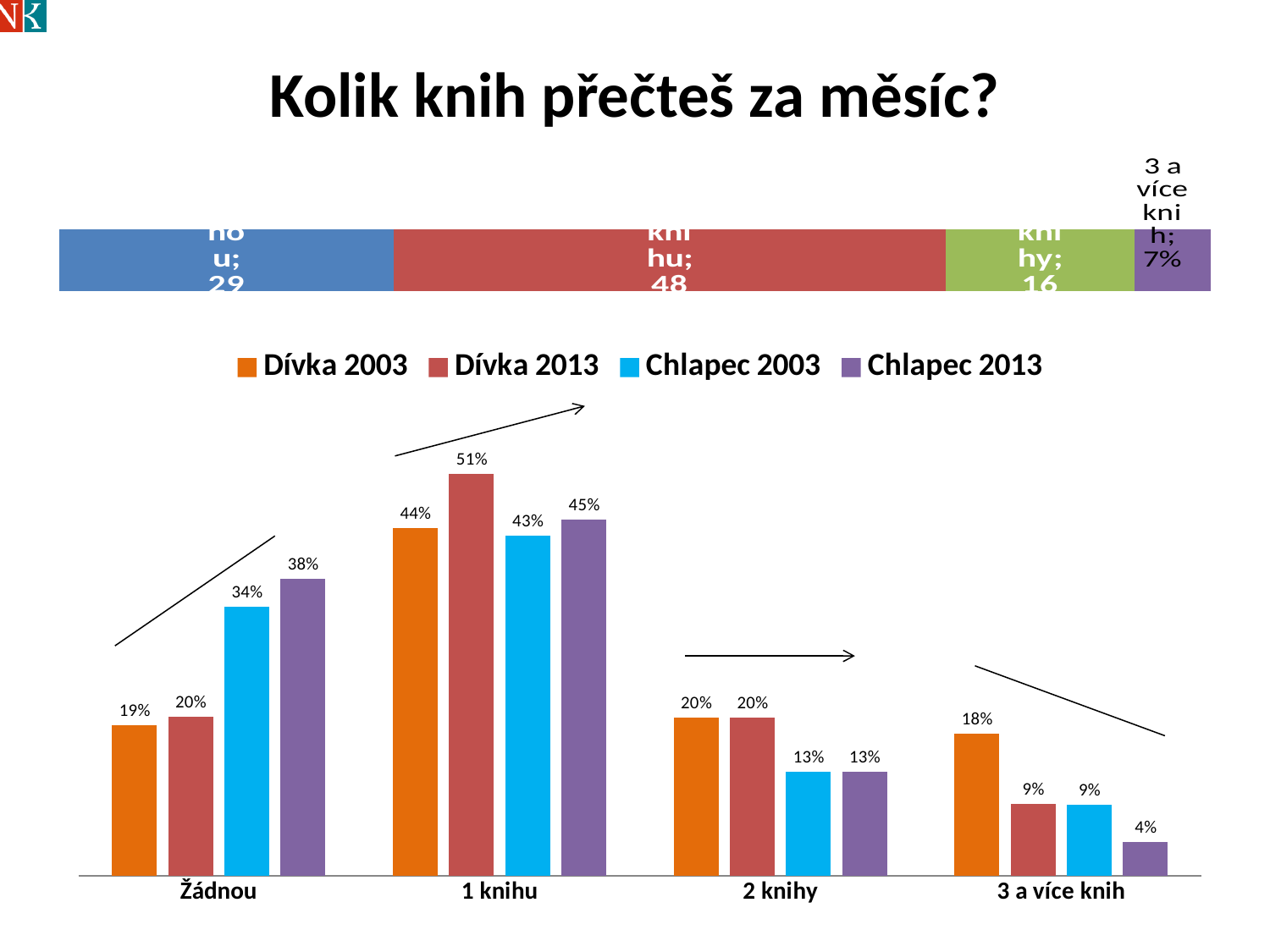
In the lower bar chart, what is the difference between Chlapec 2013 and Chlapec 2003 in the 'Žádnou' category? 4% In the lower bar chart, which series has the highest value in the '1 knihu' category? Dívka 2013 In the lower bar chart, what is the value for Dívka 2003 in the '3 a více knih' category? 18% In the lower bar chart, what is the value for Chlapec 2013 in the 'Žádnou' category? 38% In the lower bar chart, what is the difference between Dívka 2003 and Dívka 2013 in the '3 a více knih' category? 9% In the top stacked bar chart, what is the value shown for the '3 a více knih' segment? 7% In the lower bar chart, what is the value for Chlapec 2003 in the '2 knihy' category? 13% In the lower bar chart, which is larger in the 'Žádnou' category: Dívka 2003 or Chlapec 2003? Chlapec 2003 How many categories are shown on the x axis of the lower bar chart? 4 In the lower bar chart, what is the value for Dívka 2013 in the '1 knihu' category? 51% How many series does the legend of the lower bar chart list? 4 In the lower bar chart, which series has the lowest value in the '3 a více knih' category? Chlapec 2013